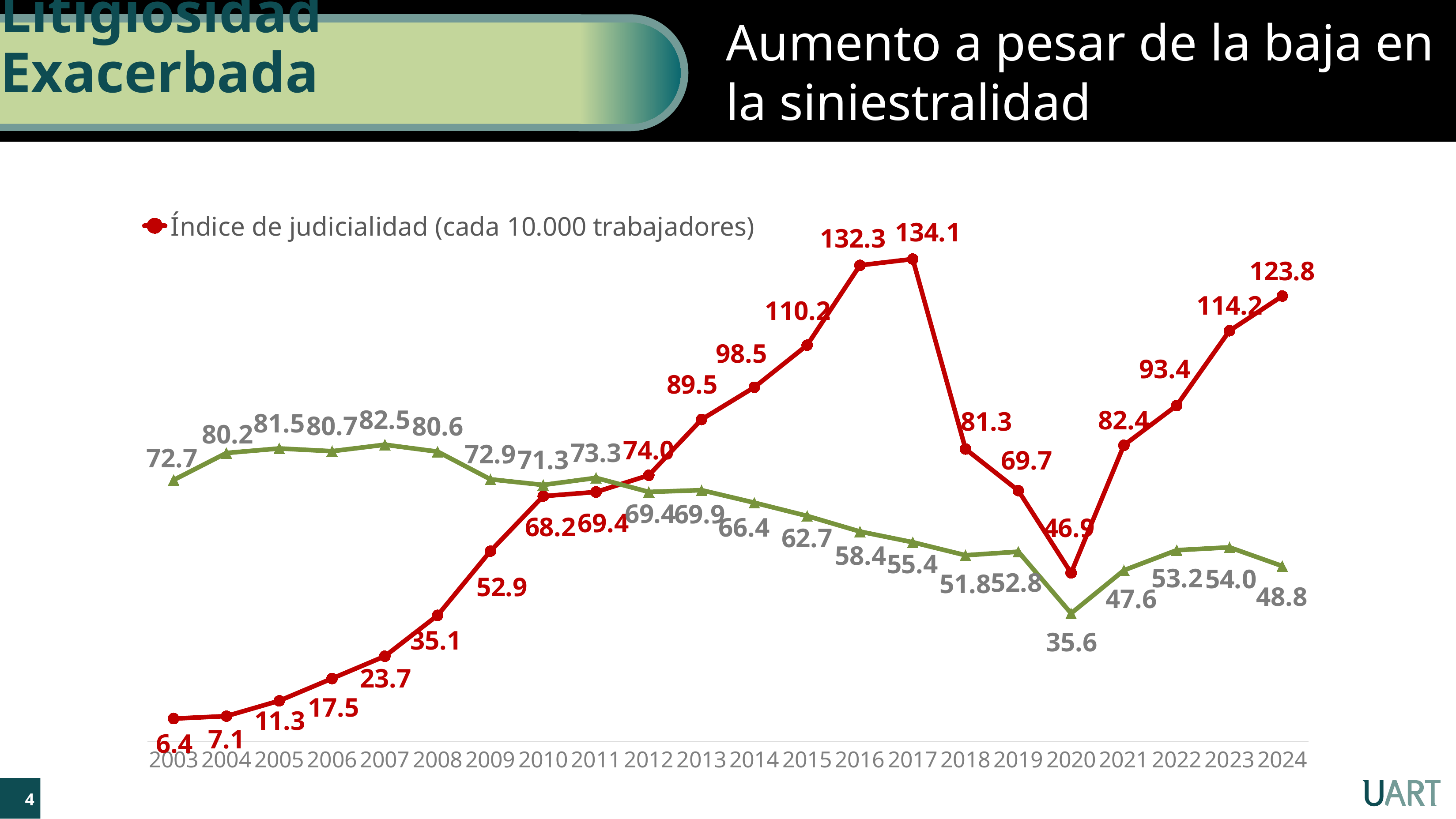
In 2020, which is larger: the Índice de judicialidad (cada 10.000 trabajadores) or the green line? Índice de judicialidad (cada 10.000 trabajadores) In which year does the Índice de judicialidad (cada 10.000 trabajadores) reach its highest value? 2017 How many years are plotted on the x axis of the chart? 22 What is the difference between the Índice de judicialidad values for 2024 and 2023? 9.6 In which year does the green line reach its lowest value? 2020 In which year is the Índice de judicialidad (cada 10.000 trabajadores) lowest? 2003 What is the value of the green line in 2003? 72.7 What type of chart is shown on the slide? Line chart By how much did the Índice de judicialidad (cada 10.000 trabajadores) fall from 2017 to 2018? 52.8 What is the value of the Índice de judicialidad (cada 10.000 trabajadores) in 2017? 134.1 What is the value of the Índice de judicialidad (cada 10.000 trabajadores) in 2024? 123.8 Does the Índice de judicialidad (cada 10.000 trabajadores) rise or fall between 2003 and 2017? Rise